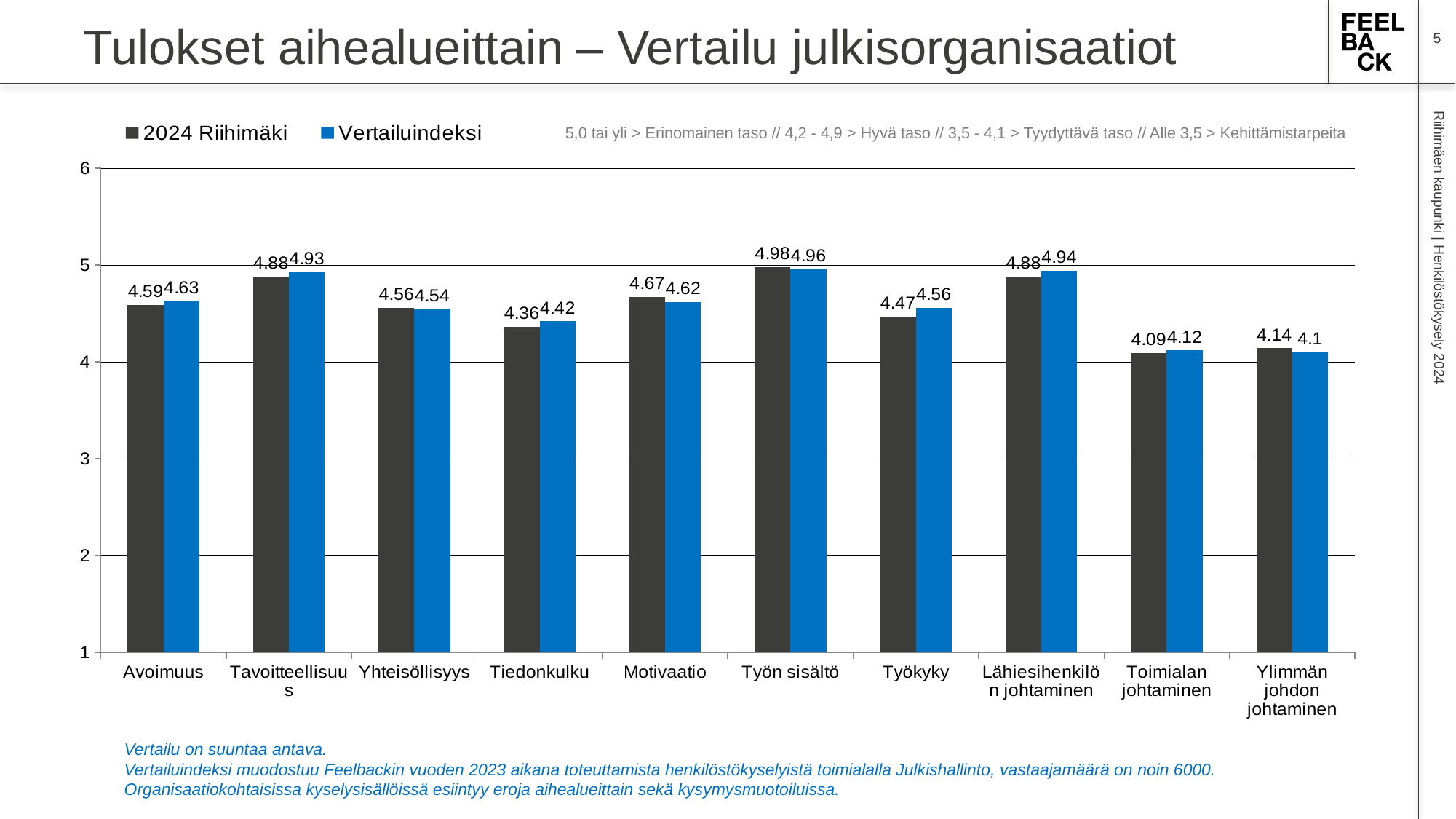
How many categories are shown on the x axis? 10 What is the difference between the Vertailuindeksi and 2024 Riihimäki values for Työkyky? 0.09 What is the 2024 Riihimäki value for Lähiesihenkilön johtaminen? 4.88 Is the 2024 Riihimäki value for Tiedonkulku greater or less than 5? less Which category has the lowest Vertailuindeksi value? Ylimmän johdon johtaminen What is the 2024 Riihimäki value for Avoimuus? 4.59 For Motivaatio, which is larger: the 2024 Riihimäki value or the Vertailuindeksi value? 2024 Riihimäki Which category has the highest 2024 Riihimäki value? Työn sisältö What kind of chart is shown on the slide? Bar chart How many series does the legend list? 2 What is the Vertailuindeksi value for Tiedonkulku? 4.42 Which category has the lowest 2024 Riihimäki value? Toimialan johtaminen